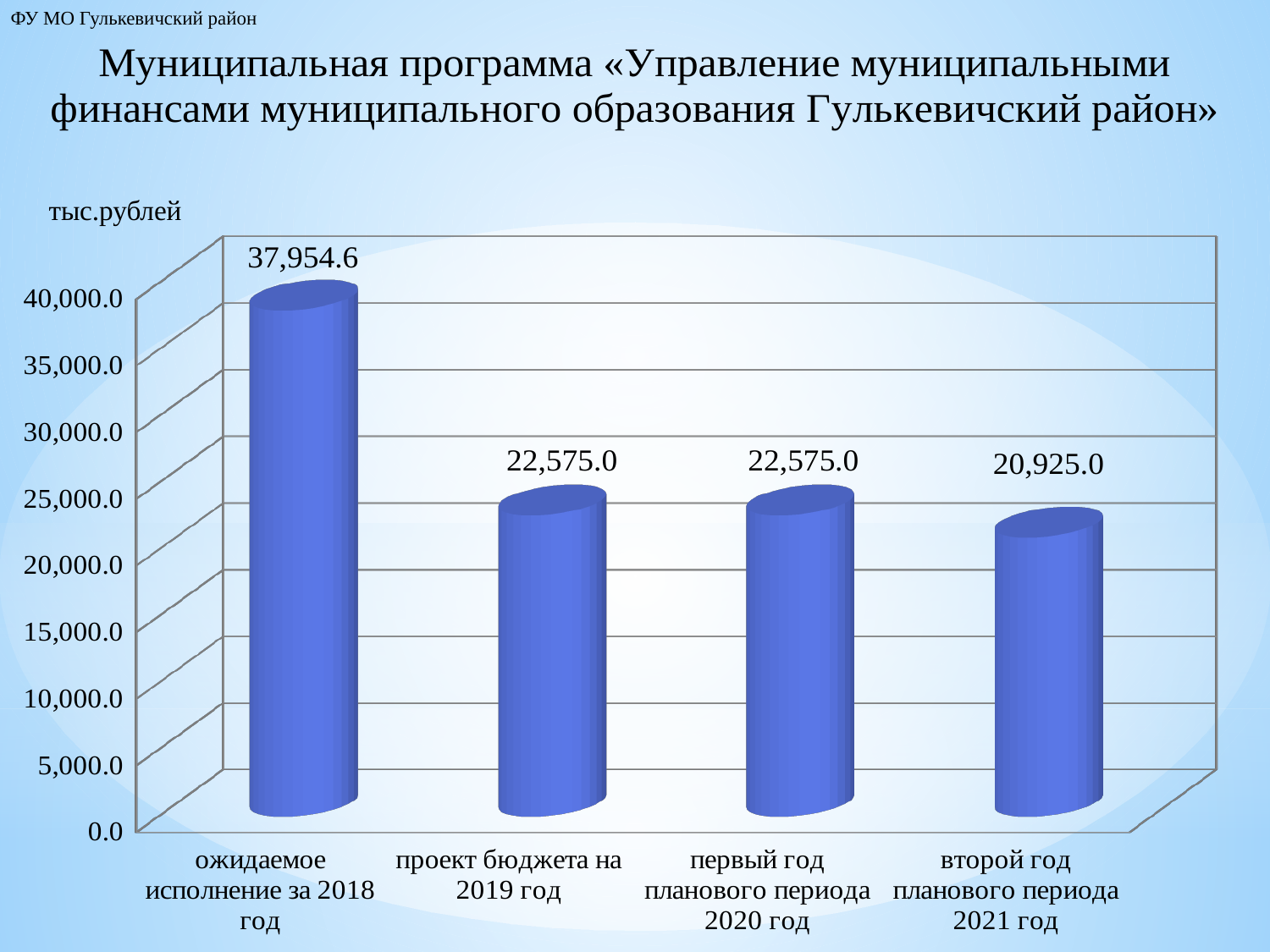
Which category has the lowest value? второй год планового периода 2021 год What is the value for 'проект бюджета на 2019 год'? 22,575.0 Is the value for 'ожидаемое исполнение за 2018 год' greater or less than 35,000.0? greater What kind of chart is shown on the slide? bar chart Which is larger: the value for 'проект бюджета на 2019 год' or the value for 'второй год планового периода 2021 год'? проект бюджета на 2019 год What is the difference between the value for 2018 (ожидаемое исполнение) and the value for 2019 (проект бюджета)? 15,379.6 What is the value for 'ожидаемое исполнение за 2018 год'? 37,954.6 What is the value for 'второй год планового периода 2021 год'? 20,925.0 What is the difference between the value for 'первый год планового периода 2020 год' and 'второй год планового периода 2021 год'? 1,650.0 How many categories are shown on the chart? 4 Which category has the highest value? ожидаемое исполнение за 2018 год What unit of measurement is indicated above the chart? тыс.рублей